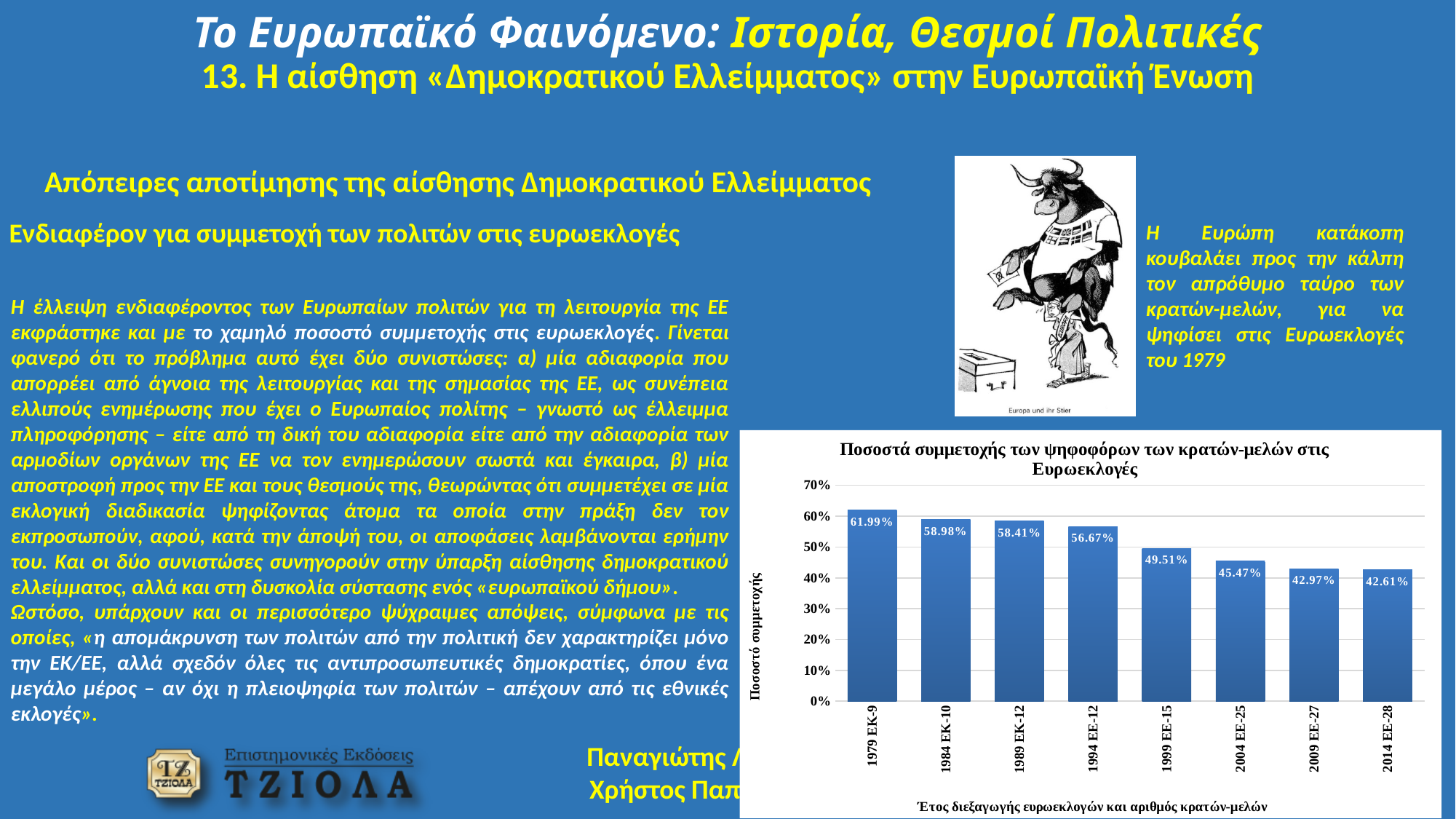
Which is larger, the turnout for 1994 ΕΕ-12 or for 2004 ΕΕ-25? 1994 ΕΕ-12 Is the value for 2009 ΕΕ-27 greater or less than 50%? less Which category has the highest turnout percentage? 1979 ΕΚ-9 What is the voter turnout value for 1979 ΕΚ-9? 61.99% What is the difference between the turnout in 1979 ΕΚ-9 and 2014 ΕΕ-28? 19.38% How many election years (categories) are shown on the x axis? 8 What is the voter turnout value for 2014 ΕΕ-28? 42.61% What is the voter turnout value for 1999 ΕΕ-15? 49.51% What type of chart is shown on the slide? bar chart What is the label of the y axis of the chart? Ποσοστό συμμετοχής Which category has the lowest turnout percentage? 2014 ΕΕ-28 Do the turnout values rise or fall from 1979 to 2014 along the x axis? fall